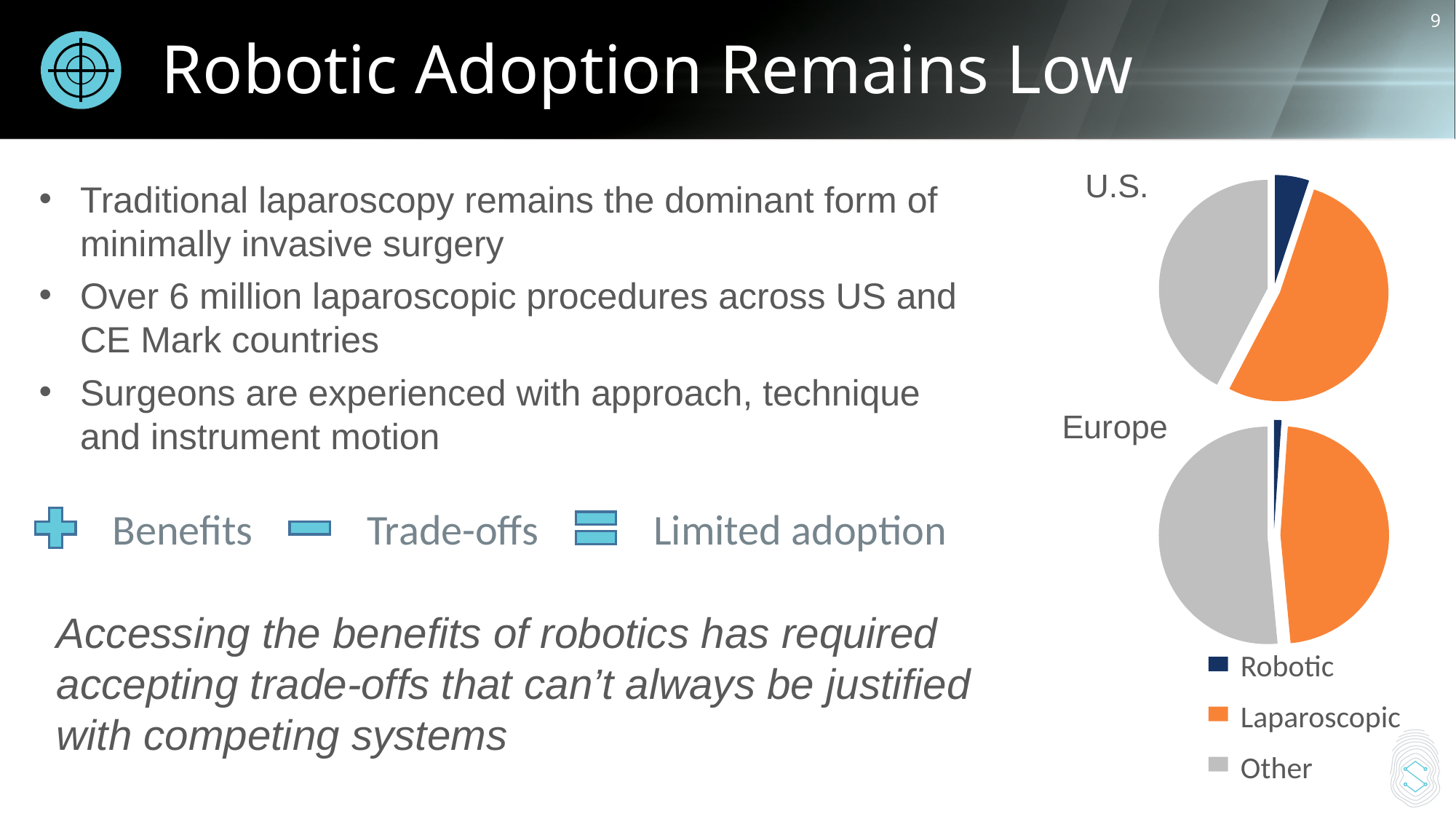
Which colour represents Laparoscopic in the pie charts? orange In the U.S. pie chart, which slice is larger, Robotic or Laparoscopic? Laparoscopic What kind of chart is the U.S. chart? pie chart In the Europe pie chart, which slice is larger, Robotic or Other? Other How many charts are shown on the slide? 2 In the U.S. pie chart, which category has the smallest slice? Robotic How many categories does the legend list for the pie charts? 3 What kind of chart is the Europe chart? pie chart Which colour represents Robotic in the pie charts? dark blue In the Europe pie chart, which category has the smallest slice? Robotic How many slices does the Europe pie chart have? 3